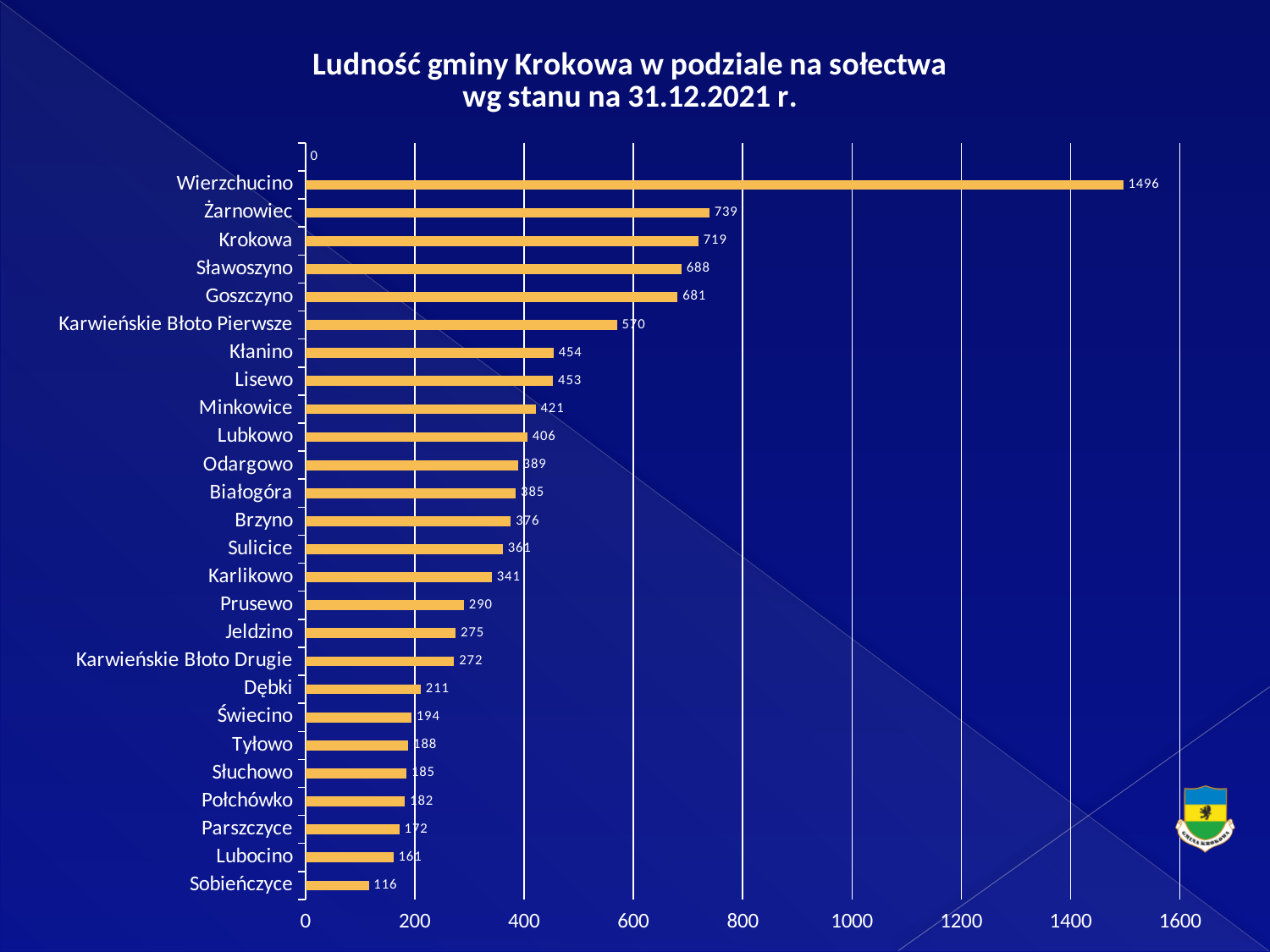
Which sołectwo has the lowest population? Sobieńczyce What is the difference in population between Wierzchucino and Sobieńczyce? 1380 What is the population of Krokowa? 719 What is the population of Dębki? 211 What is the difference in population between Żarnowiec and Krokowa? 20 What is the population of Wierzchucino? 1496 Is the value for Prusewo greater or less than 400? less What is the title of the chart? Ludność gminy Krokowa w podziale na sołectwa wg stanu na 31.12.2021 r. Which sołectwo has the highest population? Wierzchucino What is the population of Karwieńskie Błoto Pierwsze? 570 Which has a larger population, Sławoszyno or Goszczyno? Sławoszyno What type of chart is shown on the slide? bar chart